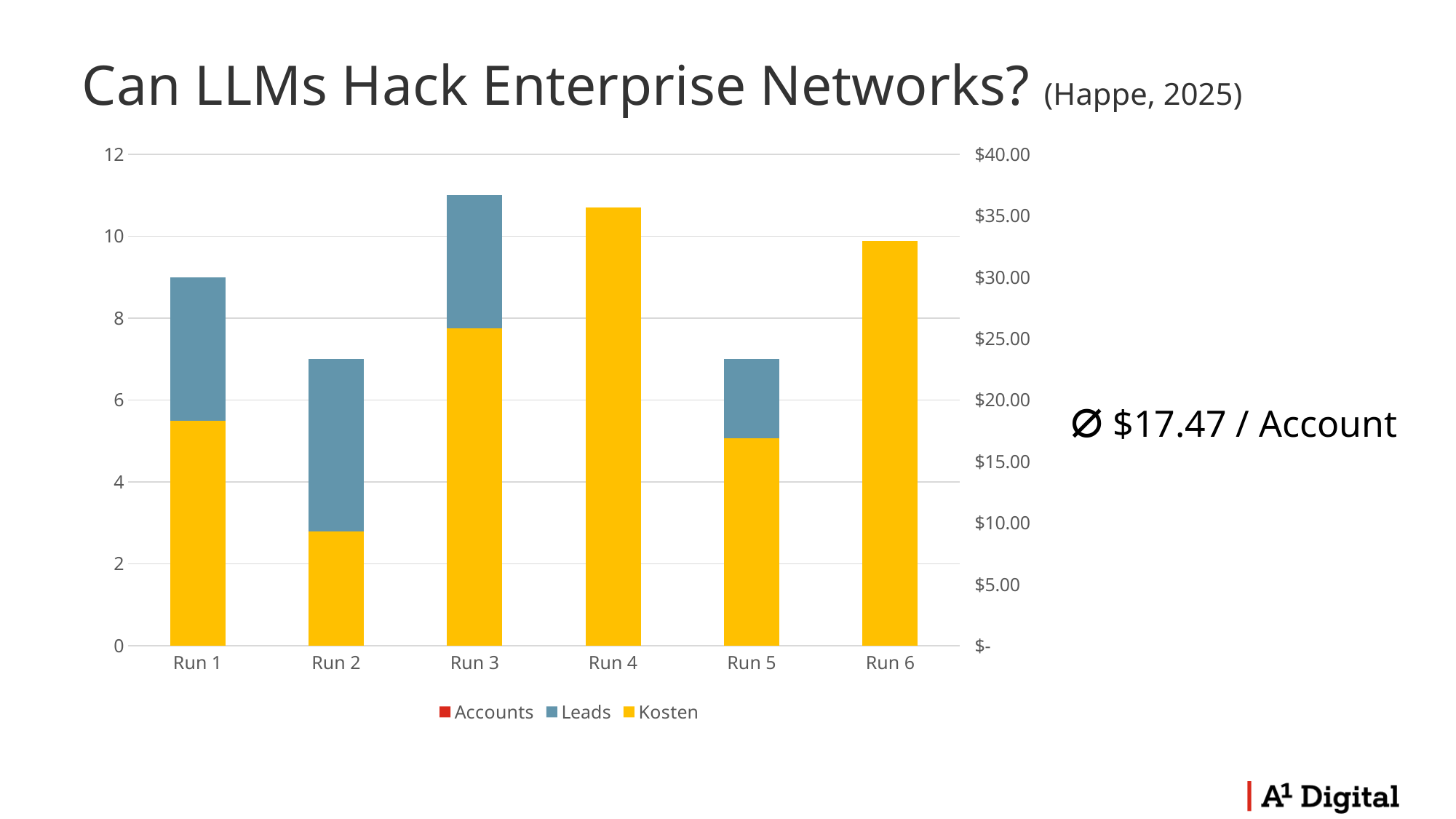
Which run has the highest Kosten value? Run 4 Is the Kosten value for Run 2 greater or less than $15.00? less What are the series names listed in the chart legend? Accounts, Leads, Kosten Is the Kosten value for Run 4 greater or less than $30.00? greater How many runs are shown on the x axis of the chart? 6 How many series does the chart legend list? 3 Which run has the lowest Kosten value? Run 2 Which run has the larger Kosten value, Run 1 or Run 6? Run 6 What kind of chart is shown on the slide? bar chart What average cost per account is stated next to the chart? $17.47 / Account Is the Leads value for Run 2 greater or less than 8? less